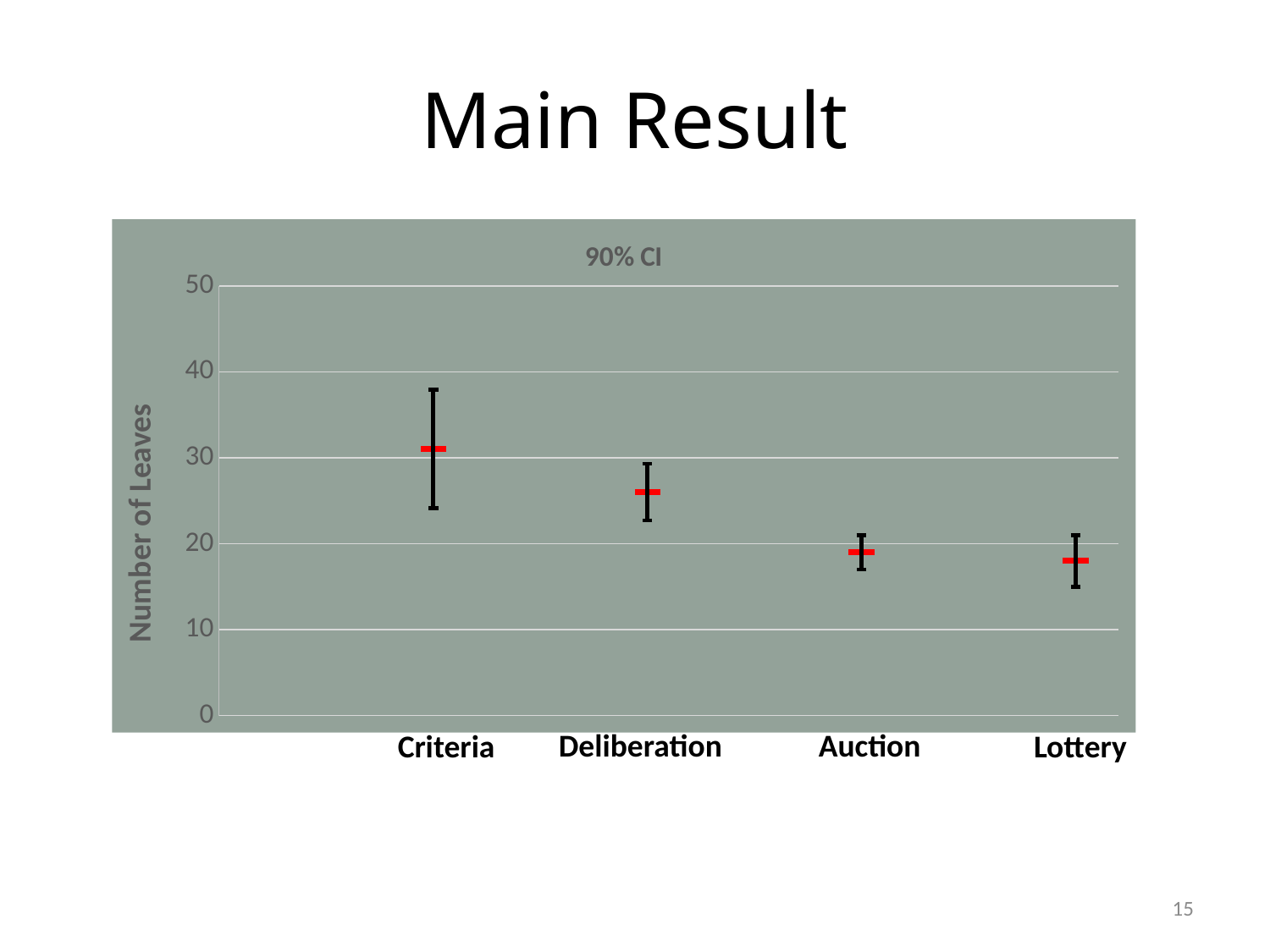
Is the value for Deliberation greater or less than 30? less Which is larger, the value for Criteria or the value for Deliberation? Criteria Do the values rise or fall moving from Criteria to Lottery along the x axis? fall How many categories are shown on the x axis of the chart? 4 What is the label on the vertical axis of the chart? Number of Leaves Is the value for Criteria greater or less than 20? greater Which category has the highest value in the chart? Criteria Is the value for Deliberation greater or less than 20? greater Which is larger, the value for Deliberation or the value for Auction? Deliberation Which is larger, the value for Criteria or the value for Lottery? Criteria